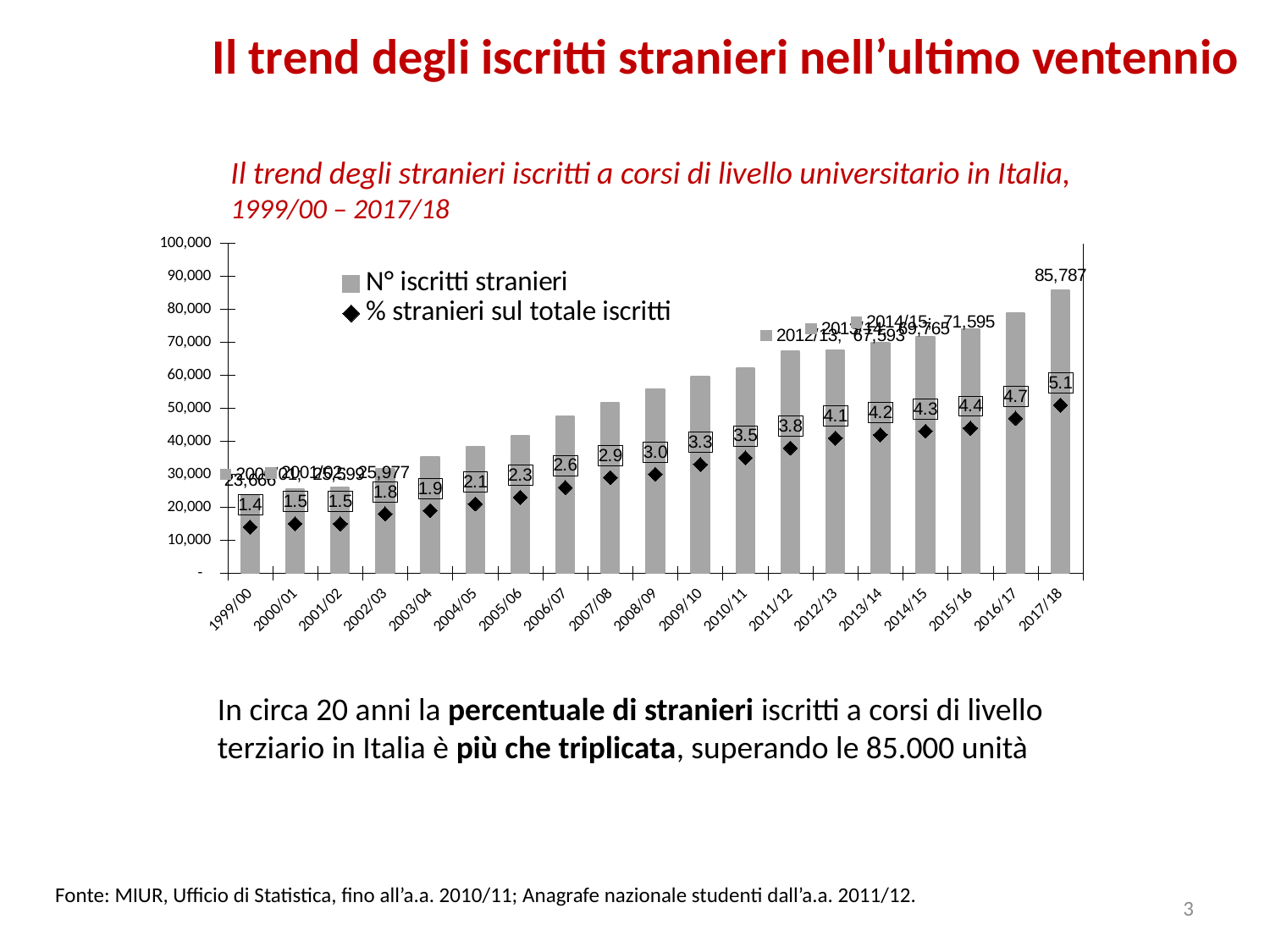
What percentage of foreign students on total enrolled is shown for 2017/18? 5.1 How many series does the legend list? 2 What is the number of foreign enrolled students (N° iscritti stranieri) labelled for 2017/18? 85,787 What percentage of foreign students on total enrolled is shown for 2008/09? 3.0 What is the difference between the percentage of foreign students in 2017/18 and in 1999/00? 3.7 Is the number of foreign enrolled students in 2010/11 greater or less than 50,000? greater What percentage of foreign students on total enrolled is shown for 1999/00? 1.4 How many academic years are shown on the x axis? 19 Which academic year has the highest percentage of foreign students on total enrolled? 2017/18 Which academic year has the lowest number of foreign enrolled students? 1999/00 Does the number of foreign enrolled students rise or fall from 1999/00 to 2017/18? rise Is the percentage of foreign students higher in 2011/12 or in 2006/07? 2011/12